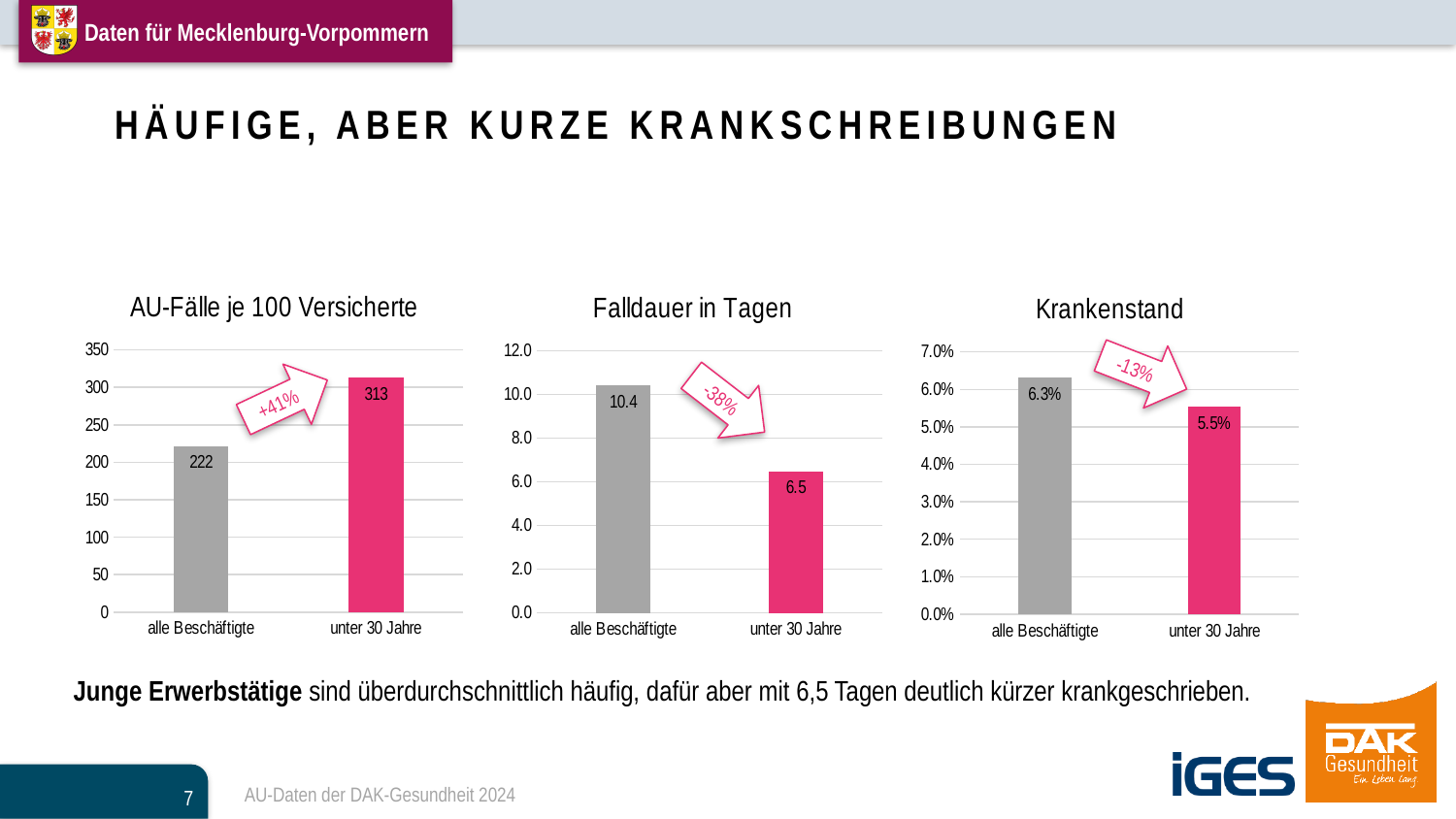
In the 'AU-Fälle je 100 Versicherte' chart, what is the value for 'alle Beschäftigte'? 222 What type of chart is the 'Krankenstand' chart? bar chart In the 'AU-Fälle je 100 Versicherte' chart, what is the difference between 'unter 30 Jahre' and 'alle Beschäftigte'? 91 In the 'Krankenstand' chart, is the value for 'alle Beschäftigte' greater or less than 'unter 30 Jahre'? greater In the 'Falldauer in Tagen' chart, which category has the lower value? unter 30 Jahre In the 'AU-Fälle je 100 Versicherte' chart, what is the value for 'unter 30 Jahre'? 313 How many categories are shown in the 'Falldauer in Tagen' chart? 2 In the 'AU-Fälle je 100 Versicherte' chart, which category has the higher value? unter 30 Jahre In the 'Falldauer in Tagen' chart, what is the value for 'unter 30 Jahre'? 6.5 In the 'Falldauer in Tagen' chart, what is the value for 'alle Beschäftigte'? 10.4 In the 'Krankenstand' chart, what is the value for 'alle Beschäftigte'? 6.3% In the 'Krankenstand' chart, what is the value for 'unter 30 Jahre'? 5.5%